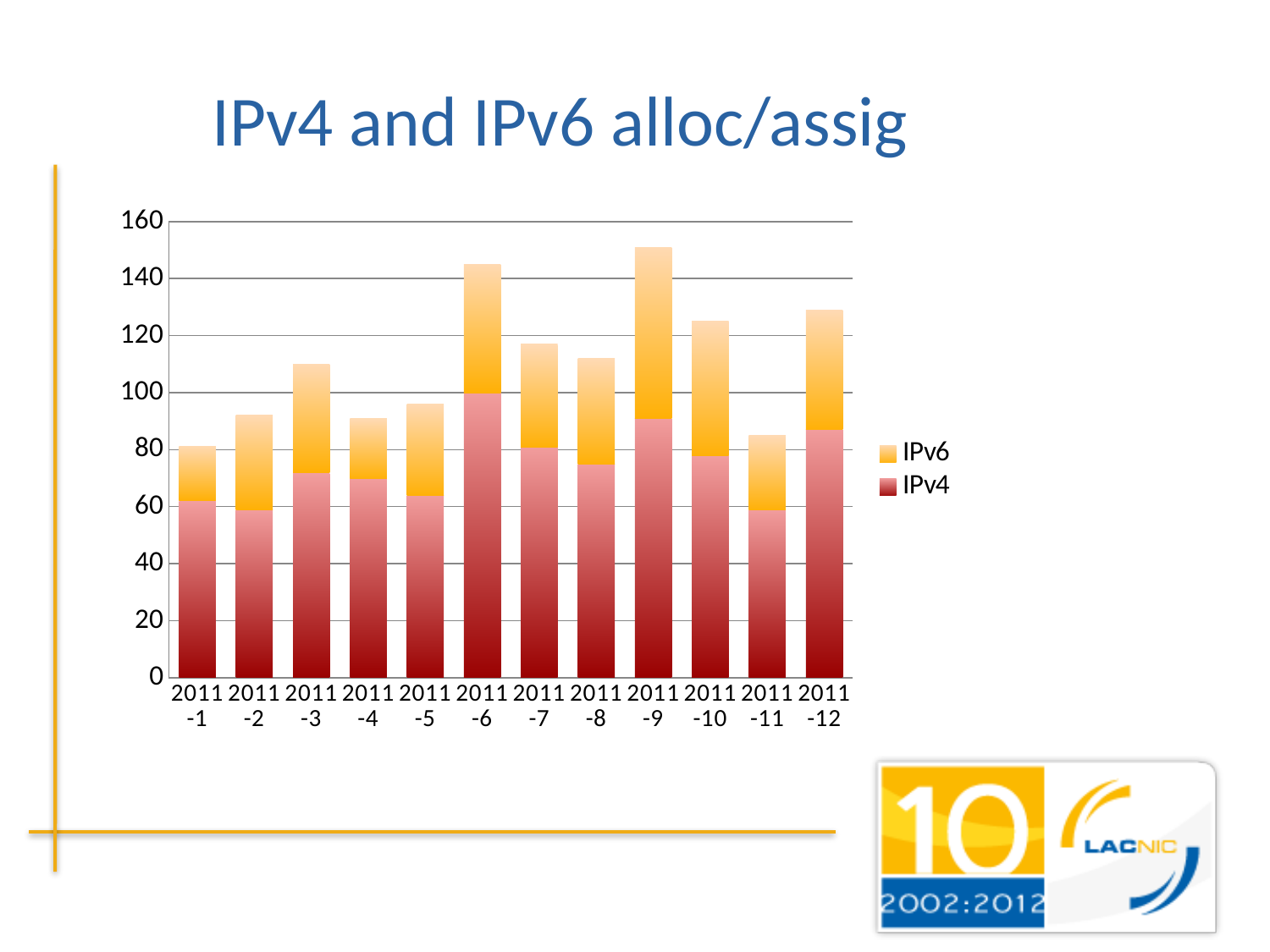
Is the total stacked value for 2011-1 greater or less than 100? less How many months (categories) are plotted along the x axis? 12 Which month has the larger IPv4 value, 2011-2 or 2011-6? 2011-6 Which two series are listed in the legend? IPv6 and IPv4 Is the total stacked value for 2011-12 greater or less than 120? greater Is the total stacked value for 2011-4 greater or less than 100? less What is the title of the chart? IPv4 and IPv6 alloc/assig How many series does the legend list? 2 Which has the larger total stacked value, 2011-6 or 2011-7? 2011-6 Which month has the tallest stacked bar (highest total)? 2011-9 What kind of chart is shown on the slide? Stacked bar chart